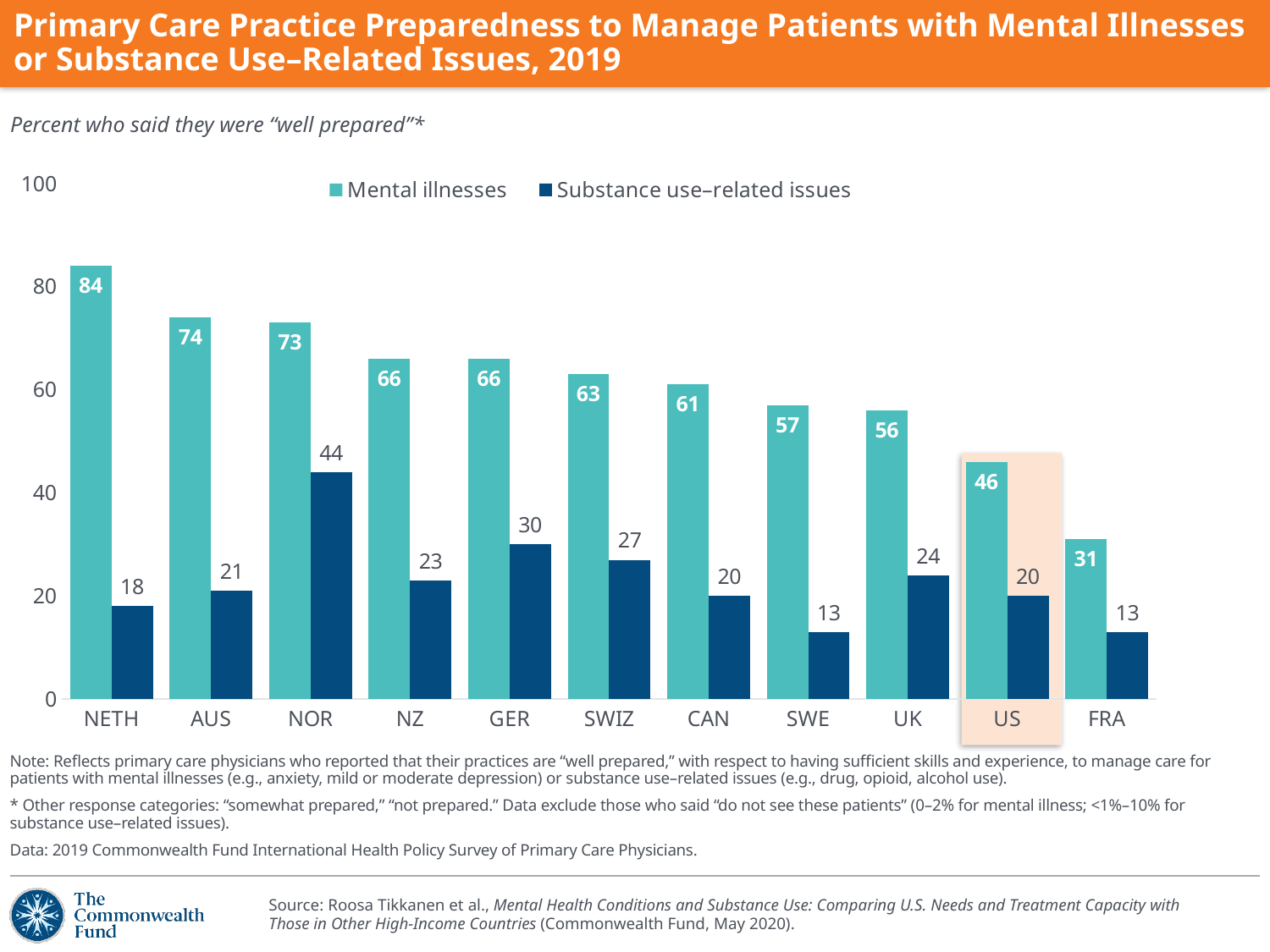
What percent of primary care physicians in NETH said they were well prepared to manage patients with mental illnesses? 84 What is the difference between the Mental illnesses and Substance use–related issues values for the US? 26 What is the value for Mental illnesses in the US? 46 What is the value for Substance use–related issues in NOR? 44 Which is larger, the Substance use–related issues value for GER or for SWIZ? GER How many series does the legend list? 2 What kind of chart is shown on the slide? Bar chart Which country has the highest value for Substance use–related issues? NOR How many countries are shown on the x axis? 11 Which country has the highest value for Mental illnesses? NETH Which country has the lowest value for Mental illnesses? FRA Which country is highlighted with a shaded background on the chart? US